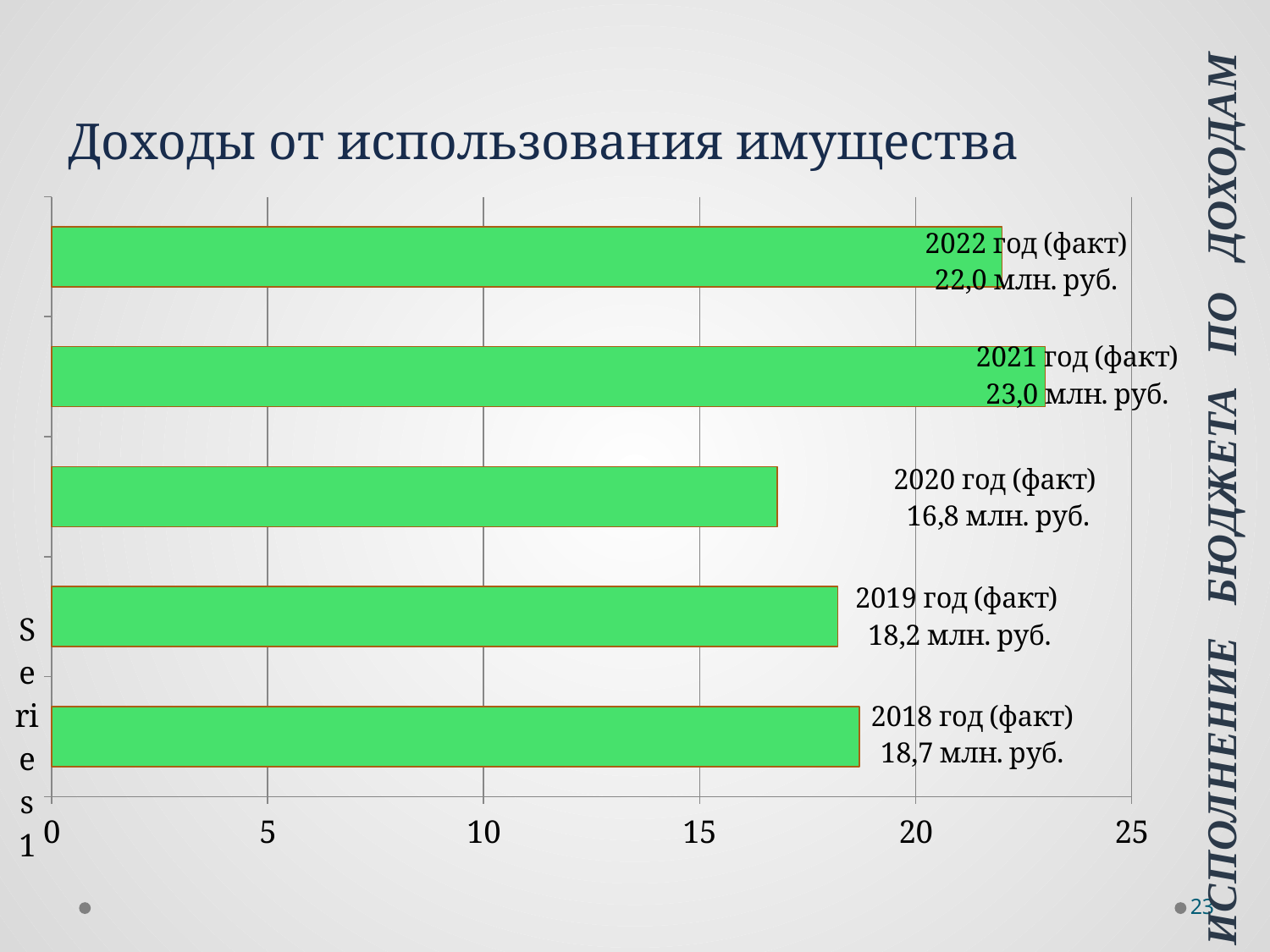
Which year has the highest value? 2021 год (факт) What kind of chart is shown on the slide? bar chart Which is larger, the value for 2019 год (факт) or 2020 год (факт)? 2019 год (факт) Is the value for 2022 год (факт) greater or less than 20? greater Which year has the lowest value? 2020 год (факт) What is the value for 2020 год (факт)? 16,8 млн. руб. What is the value for 2018 год (факт)? 18,7 млн. руб. How many bars are shown in the chart? 5 What is the difference between the values for 2021 год (факт) and 2022 год (факт)? 1,0 млн. руб. What is the title of the chart? Доходы от использования имущества What is the difference between the values for 2018 год (факт) and 2019 год (факт)? 0,5 млн. руб. What is the value for 2021 год (факт)? 23,0 млн. руб.